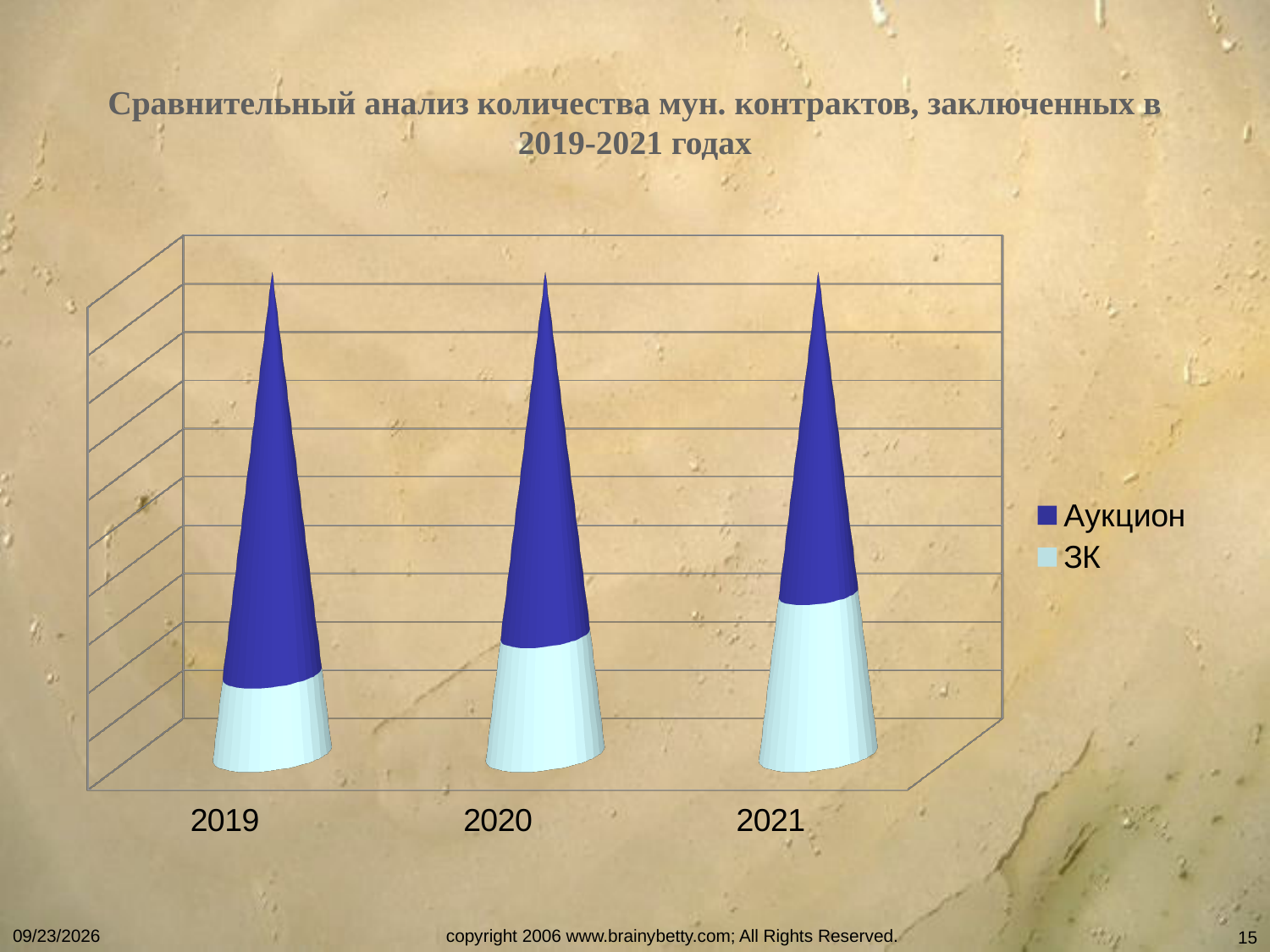
What kind of chart is shown on the slide? bar chart In which year is the ЗК segment the largest? 2021 How many series does the chart's legend list? 2 In which year is the ЗК segment the smallest? 2019 Which is larger, the ЗК segment for 2019 or the ЗК segment for 2021? 2021 In which year is the Аукцион segment the smallest? 2021 Does the ЗК segment rise or fall from 2019 to 2021? rise Does the Аукцион segment rise or fall from 2019 to 2021? fall How many years (categories) are shown on the x axis of the chart? 3 What are the two series named in the chart's legend? Аукцион and ЗК In which year is the Аукцион segment the largest? 2019 What is the title of the chart on the slide? Сравнительный анализ количества мун. контрактов, заключенных в 2019-2021 годах